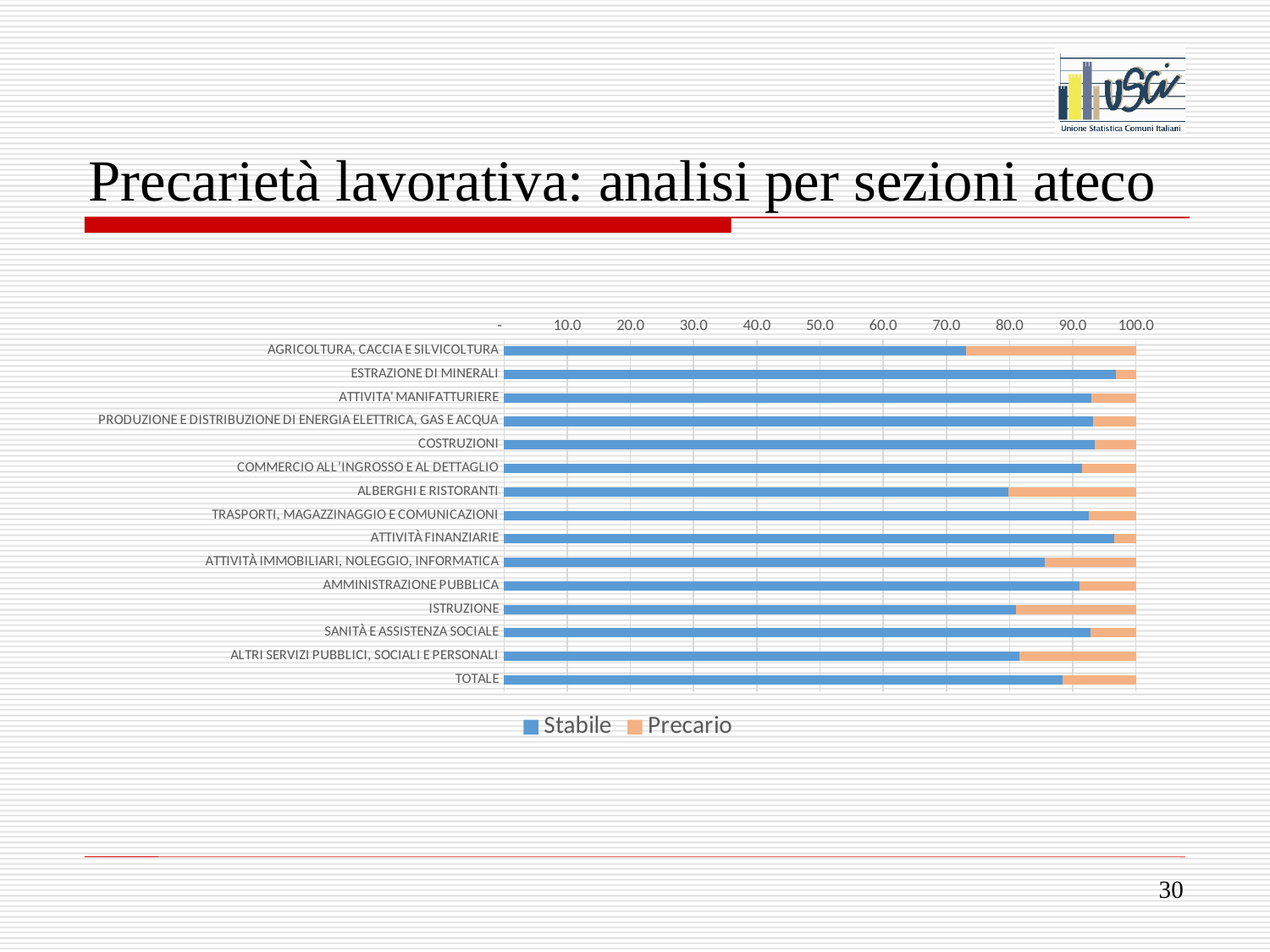
How many series does the legend list? 2 Is the Stabile value for TOTALE greater or less than 80.0? greater Is the Stabile value for AGRICOLTURA, CACCIA E SILVICOLTURA greater or less than 80.0? less What are the two series named in the legend? Stabile and Precario Is the Stabile value for ATTIVITÀ IMMOBILIARI, NOLEGGIO, INFORMATICA greater or less than 90.0? less Which has the larger Stabile value, COSTRUZIONI or ALBERGHI E RISTORANTI? COSTRUZIONI Which category has the lowest Stabile value? AGRICOLTURA, CACCIA E SILVICOLTURA Which has the larger Precario segment, ISTRUZIONE or ESTRAZIONE DI MINERALI? ISTRUZIONE What kind of chart is shown on the slide? Stacked horizontal bar chart Which category has the largest Precario segment? AGRICOLTURA, CACCIA E SILVICOLTURA How many categories (bars) are plotted on the chart, including TOTALE? 15